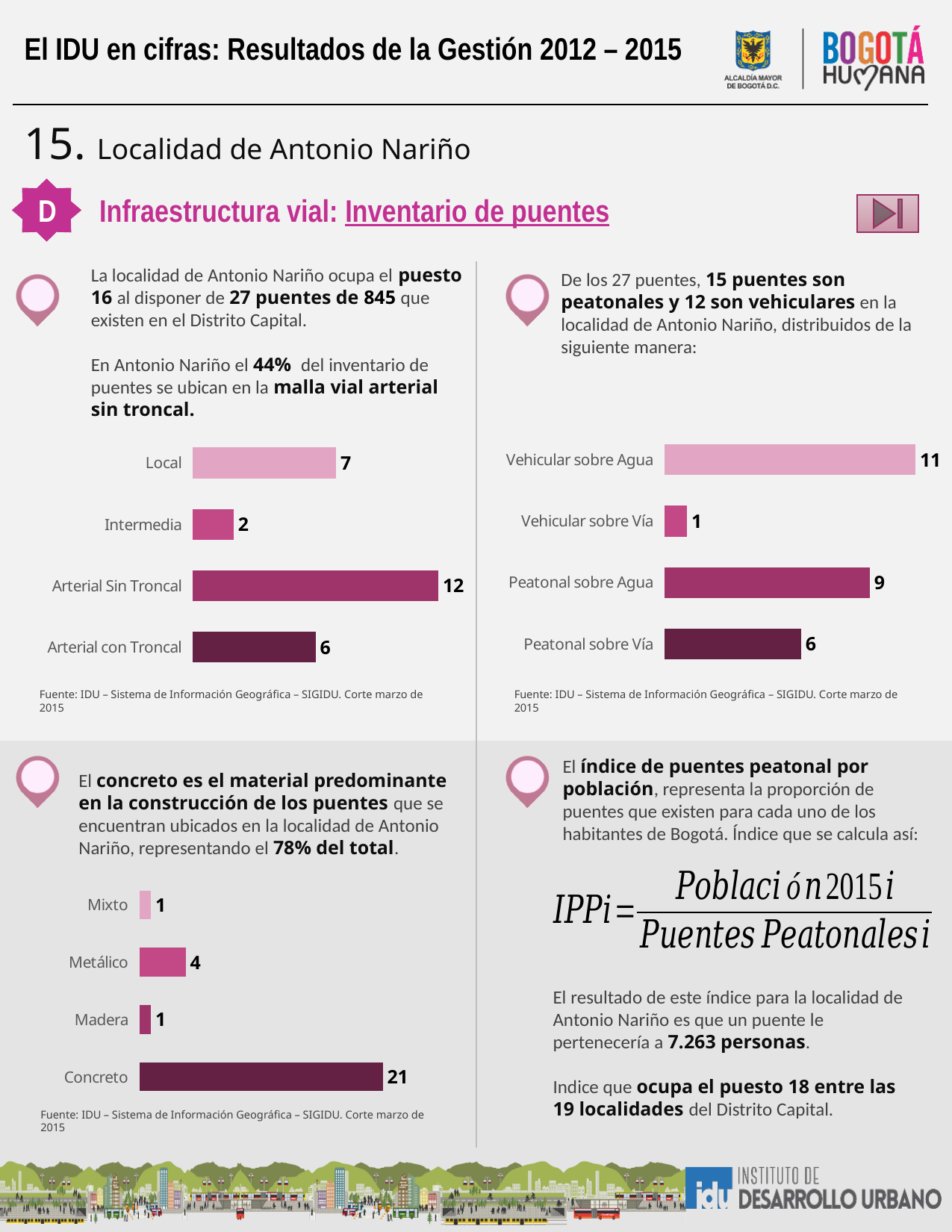
In the bottom-left bar chart, what is the value for Metálico? 4 In the top-right bar chart, which category has the highest value? Vehicular sobre Agua In the bottom-left bar chart, what is the value for Concreto? 21 What kind of chart is the bottom-left chart? Bar chart In the top-left bar chart, what is the difference between the values for Local and Arterial con Troncal? 1 In the bottom-left bar chart, what is the total of all four categories? 27 In the top-right bar chart, which is larger, Peatonal sobre Agua or Peatonal sobre Vía? Peatonal sobre Agua In the top-left bar chart, how many categories are shown? 4 In the top-left bar chart, which category has the lowest value? Intermedia In the top-left bar chart, what is the value for Arterial Sin Troncal? 12 In the top-right bar chart, what is the difference between Vehicular sobre Agua and Vehicular sobre Vía? 10 In the top-right bar chart, what is the value for Vehicular sobre Agua? 11